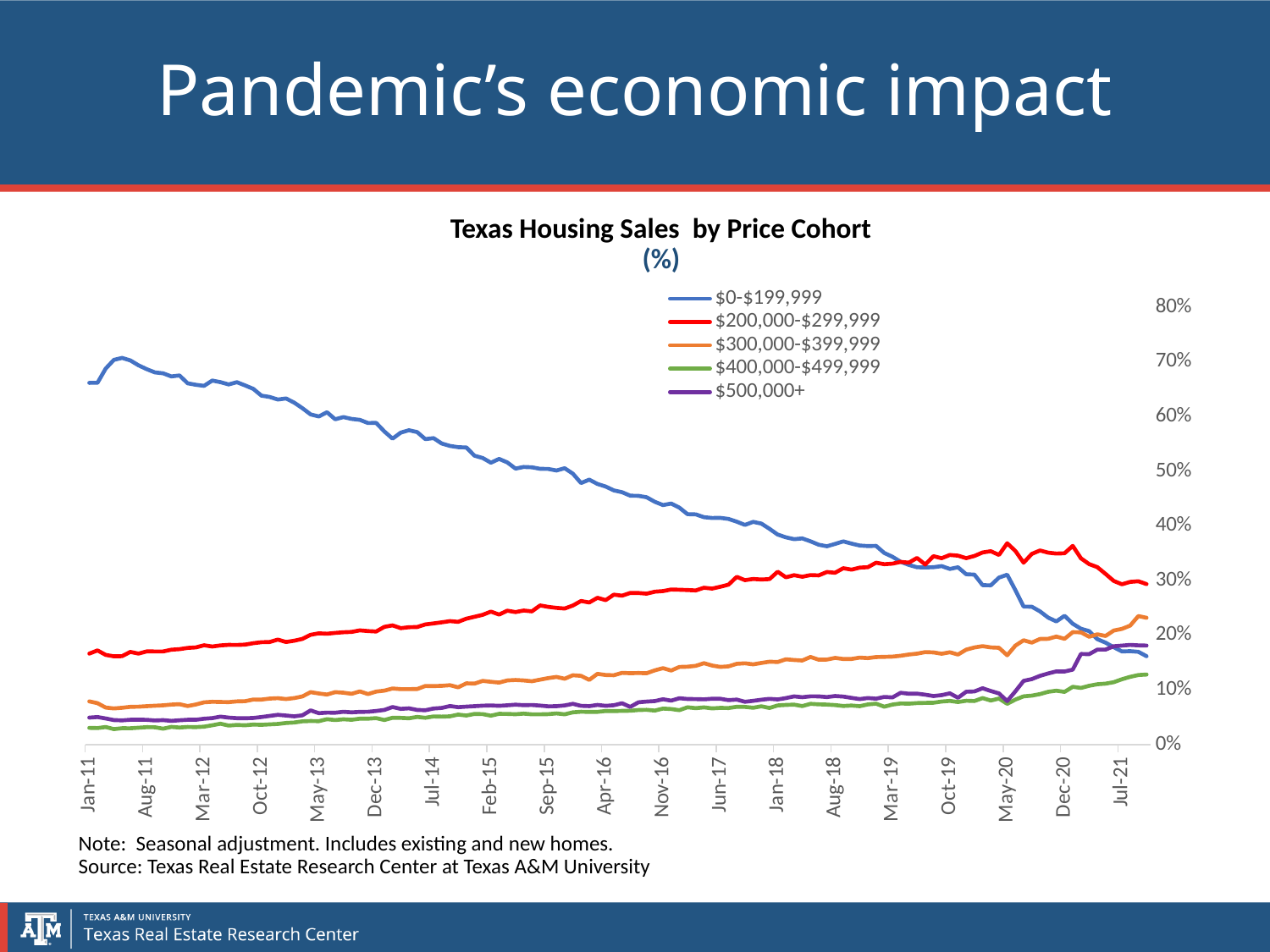
How many series does the legend list? 5 Which series has the highest value at Jan-11? $0-$199,999 Which series has the lowest value at Jan-11? $400,000-$499,999 What is the title of the chart? Texas Housing Sales by Price Cohort (%) Which colour is used for the $200,000-$299,999 series? Red At Jul-21, which is larger: the $200,000-$299,999 series or the $0-$199,999 series? $200,000-$299,999 Is the value for $0-$199,999 at Jul-21 greater or less than 20%? less Is the value for $200,000-$299,999 at Jan-11 greater or less than 20%? less Is the value for $0-$199,999 at Jan-11 greater or less than 60%? greater What kind of chart is shown on the slide? Line chart Does the $0-$199,999 series rise or fall from Jan-11 to Jul-21? Fall Does the $200,000-$299,999 series rise or fall from Jan-11 to Jul-21? Rise